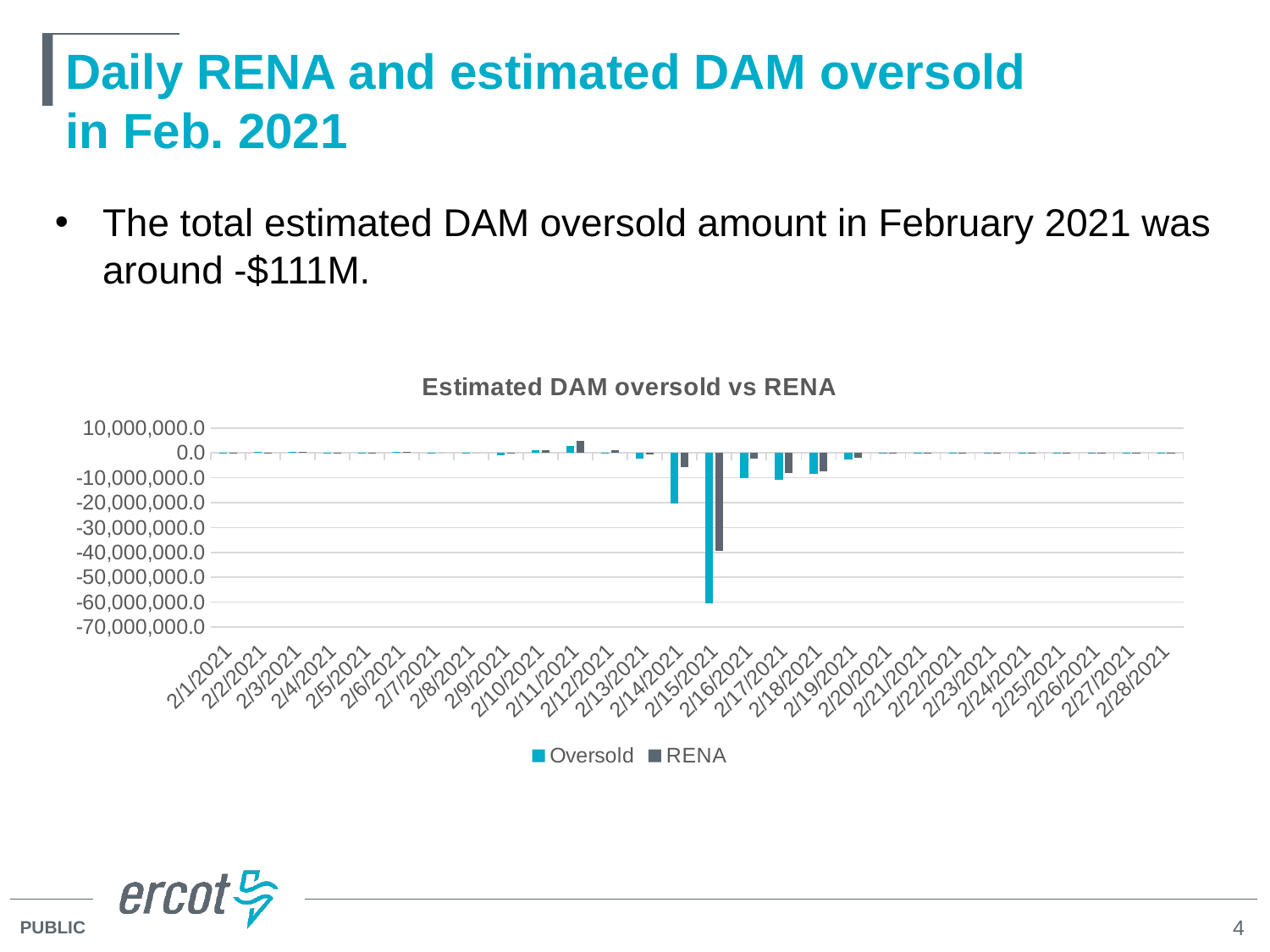
What type of chart is shown on the slide? Bar chart What is the title of the chart? Estimated DAM oversold vs RENA Is the Oversold value for 2/15/2021 greater or less than -50,000,000.0? less How many dates are shown along the x axis of the chart? 28 On 2/15/2021, which series has the larger (less negative) value, Oversold or RENA? RENA Is the Oversold value for 2/14/2021 greater or less than -30,000,000.0? greater Which colour represents the Oversold series in the chart? Teal (blue) On which date does the RENA series reach its lowest value? 2/15/2021 Is the RENA value for 2/15/2021 greater or less than -30,000,000.0? less On which date does the Oversold series reach its lowest value? 2/15/2021 How many series does the chart legend list? 2